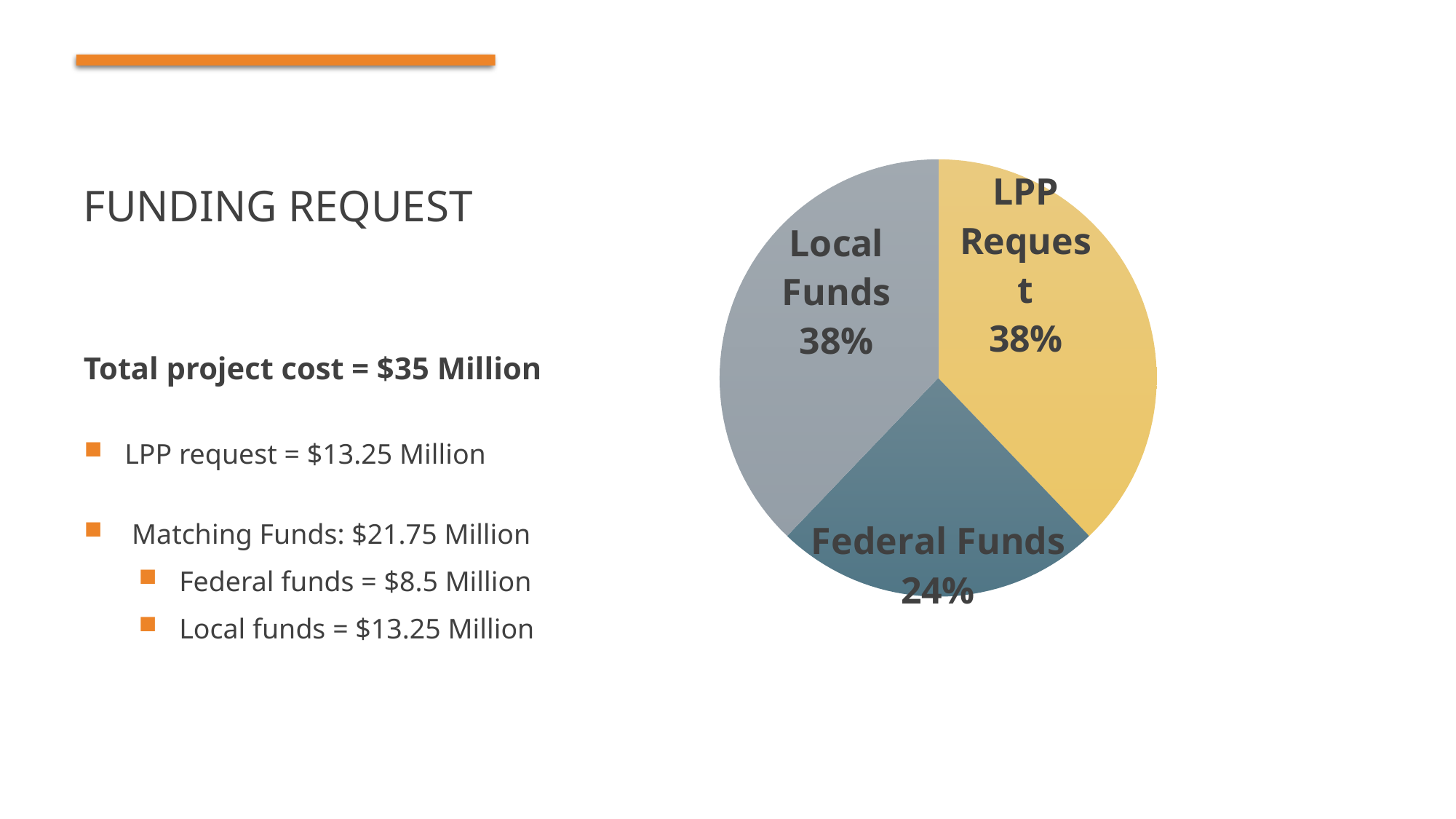
What kind of chart is shown on the slide? pie chart How many slices does the pie chart have? 3 Which is larger, the Local Funds slice or the Federal Funds slice? Local Funds What share of the pie does Federal Funds represent? 24% What share of the pie does LPP Request represent? 38% What is the difference in percentage points between the LPP Request slice and the Federal Funds slice? 14 Which slice of the pie chart is the smallest? Federal Funds What colour is the LPP Request slice? yellow What share of the pie does Local Funds represent? 38% What colour is the Federal Funds slice? teal Is the share for Federal Funds greater or less than 30%? less